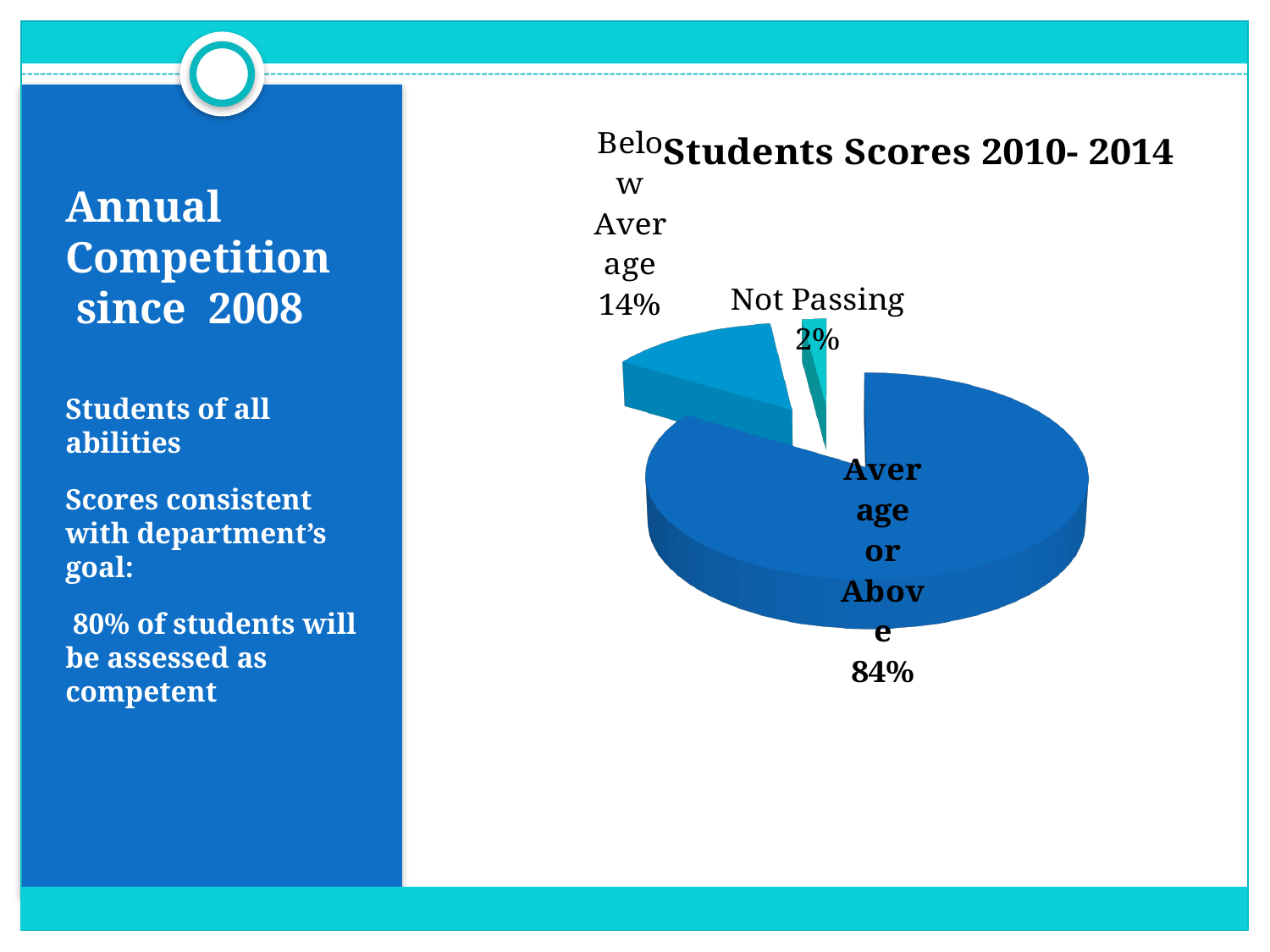
What is the title of the pie chart? Students Scores 2010- 2014 What is the combined share of Below Average and Not Passing? 16% What is the difference between the Below Average share and the Not Passing share? 12% Which category has the smallest share of the pie? Not Passing What percentage of students were Not Passing? 2% Which is larger, the Below Average share or the Not Passing share? Below Average What kind of chart is shown on the slide? pie chart Which category has the largest share of the pie? Average or Above What is the difference between the Average or Above share and the Below Average share? 70% What percentage of students scored Below Average? 14% What percentage of students scored Average or Above? 84% How many slices does the pie chart have? 3